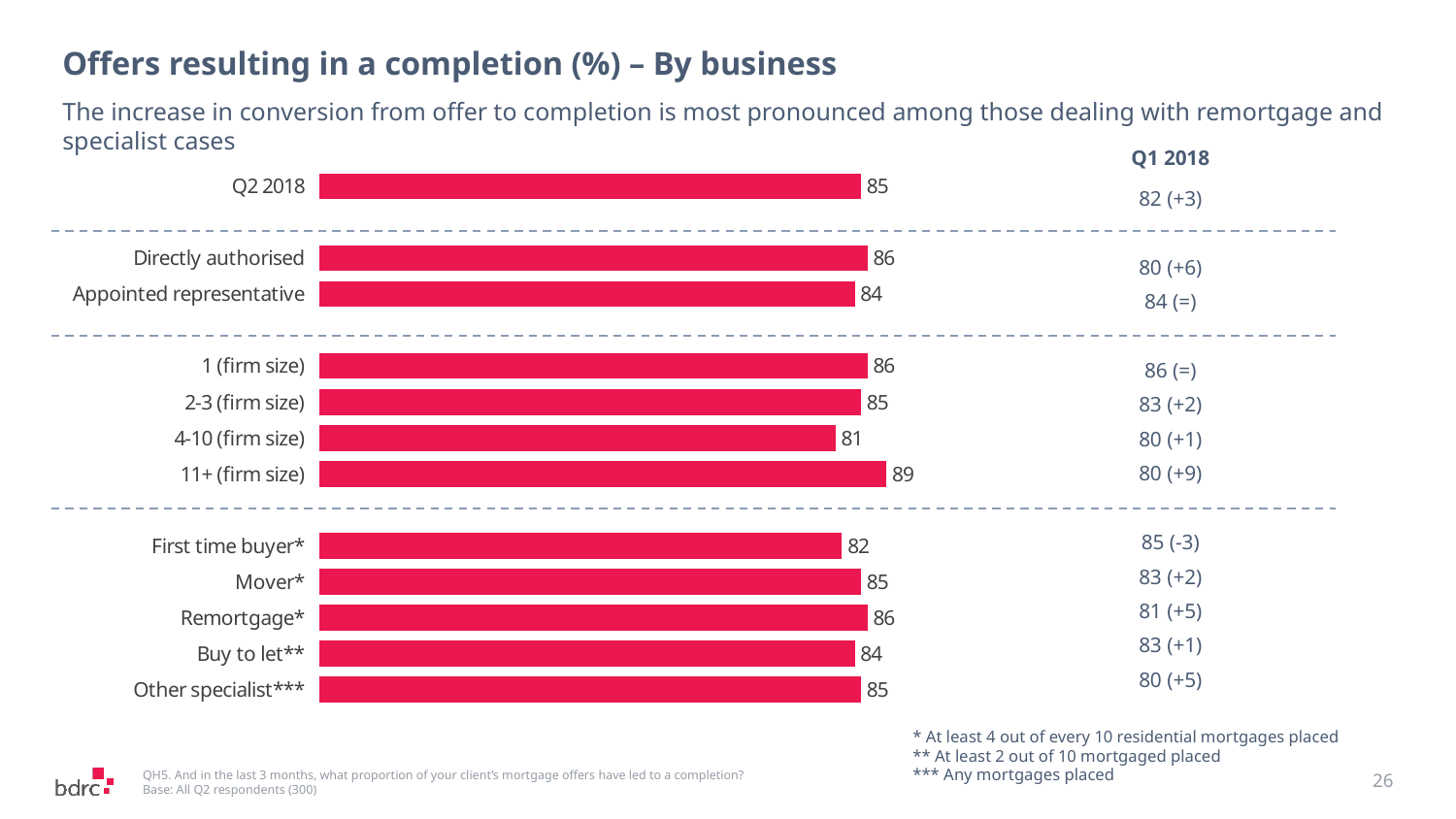
Which category has the highest value? 11+ (firm size) Which is larger, the value for Remortgage* or the value for First time buyer*? Remortgage* What kind of chart is shown on the slide? Bar chart Which category has the lowest value? 4-10 (firm size) What is the difference between the values for 11+ (firm size) and 4-10 (firm size)? 8 What is the value for Q2 2018 (the top bar)? 85 What is the value for First time buyer*? 82 What is the value for 11+ (firm size)? 89 What is the title of the chart on the slide? Offers resulting in a completion (%) – By business What is the value for Appointed representative? 84 How many bars are plotted in the chart? 12 What is the difference between the values for Directly authorised and Appointed representative? 2